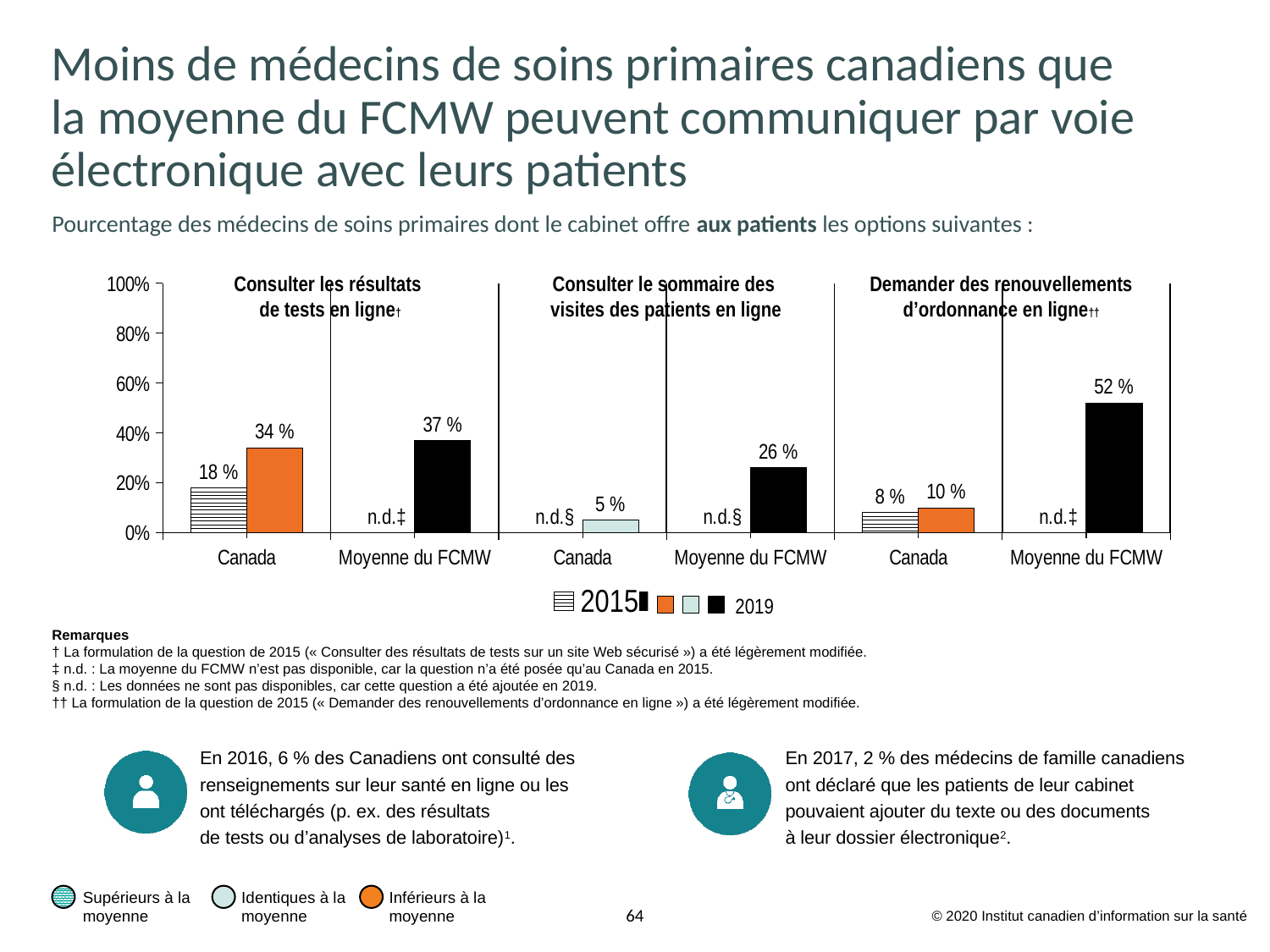
What is the 2019 value for Canada under "Consulter les résultats de tests en ligne"? 34 % How many series does the chart legend list? 2 Which 2019 bar on the chart is the lowest? Canada, Consulter le sommaire des visites des patients en ligne (5 %) Under "Consulter les résultats de tests en ligne", which 2019 value is larger: Canada or Moyenne du FCMW? Moyenne du FCMW Which 2019 bar on the chart is the highest? Moyenne du FCMW, Demander des renouvellements d'ordonnance en ligne (52 %) What is the 2015 value for Canada under "Consulter les résultats de tests en ligne"? 18 % By how much did Canada's value for "Consulter les résultats de tests en ligne" increase from 2015 to 2019? 16 % What is the 2019 value for Canada under "Consulter le sommaire des visites des patients en ligne"? 5 % What is the 2019 value for Moyenne du FCMW under "Consulter le sommaire des visites des patients en ligne"? 26 % What kind of chart is shown on the slide? Bar chart What is the difference between the 2019 values for Moyenne du FCMW and Canada under "Demander des renouvellements d'ordonnance en ligne"? 42 % What is the 2019 value for Moyenne du FCMW under "Demander des renouvellements d'ordonnance en ligne"? 52 %